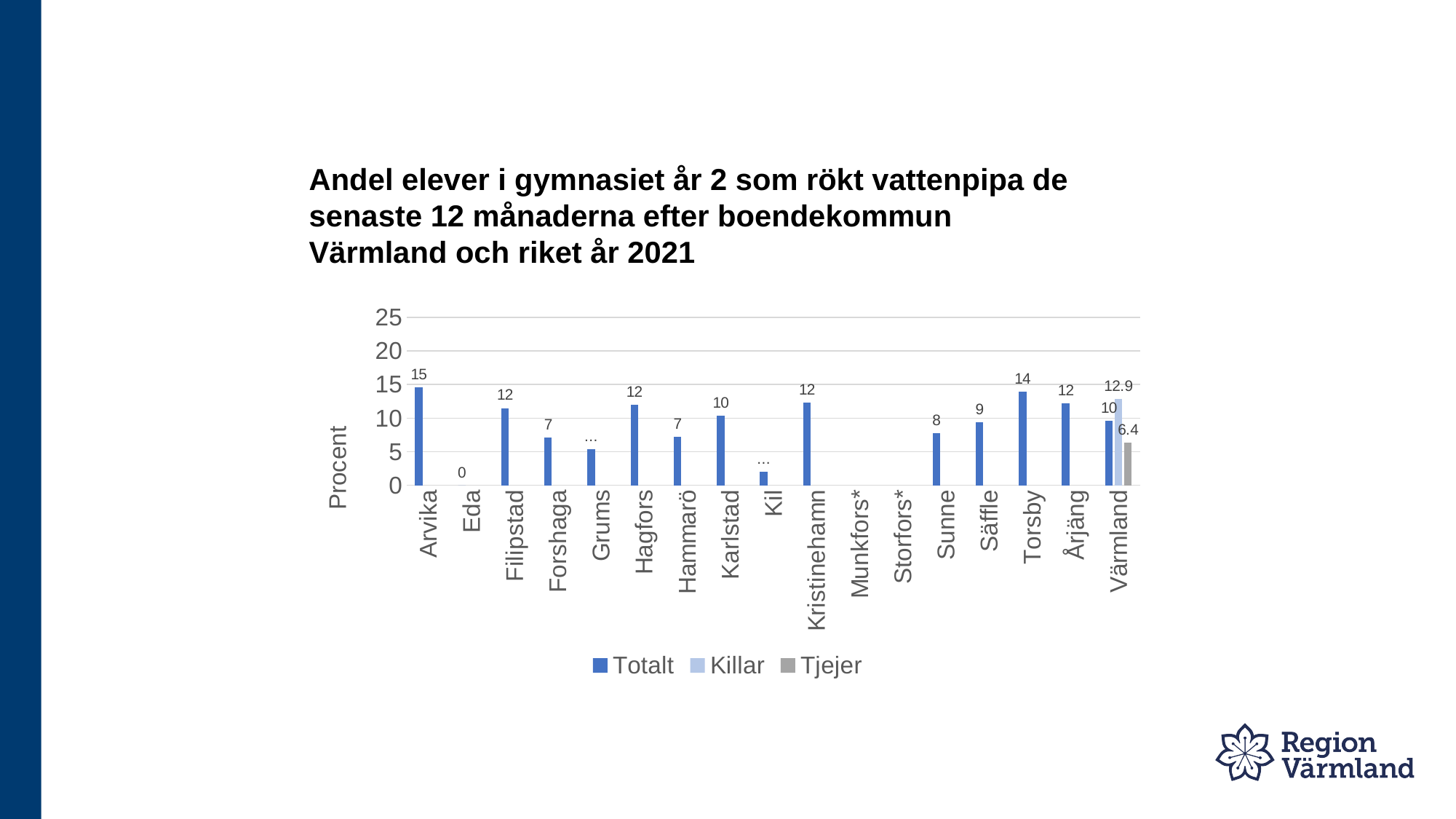
Which has a higher Totalt value, Karlstad or Hagfors? Hagfors What is the Tjejer value for Värmland? 6.4 How many series does the legend list? 3 What type of chart is shown on the slide? bar chart Which municipality has the lowest labelled Totalt value? Eda Which municipality has the highest Totalt value? Arvika Is the Totalt value for Grums greater or less than 10? less What is the difference between the Totalt values for Arvika and Sunne? 7 What is the label on the vertical axis? Procent What is the Totalt value for Arvika? 15 What is the Totalt value for Torsby? 14 What is the Killar value for Värmland? 12.9